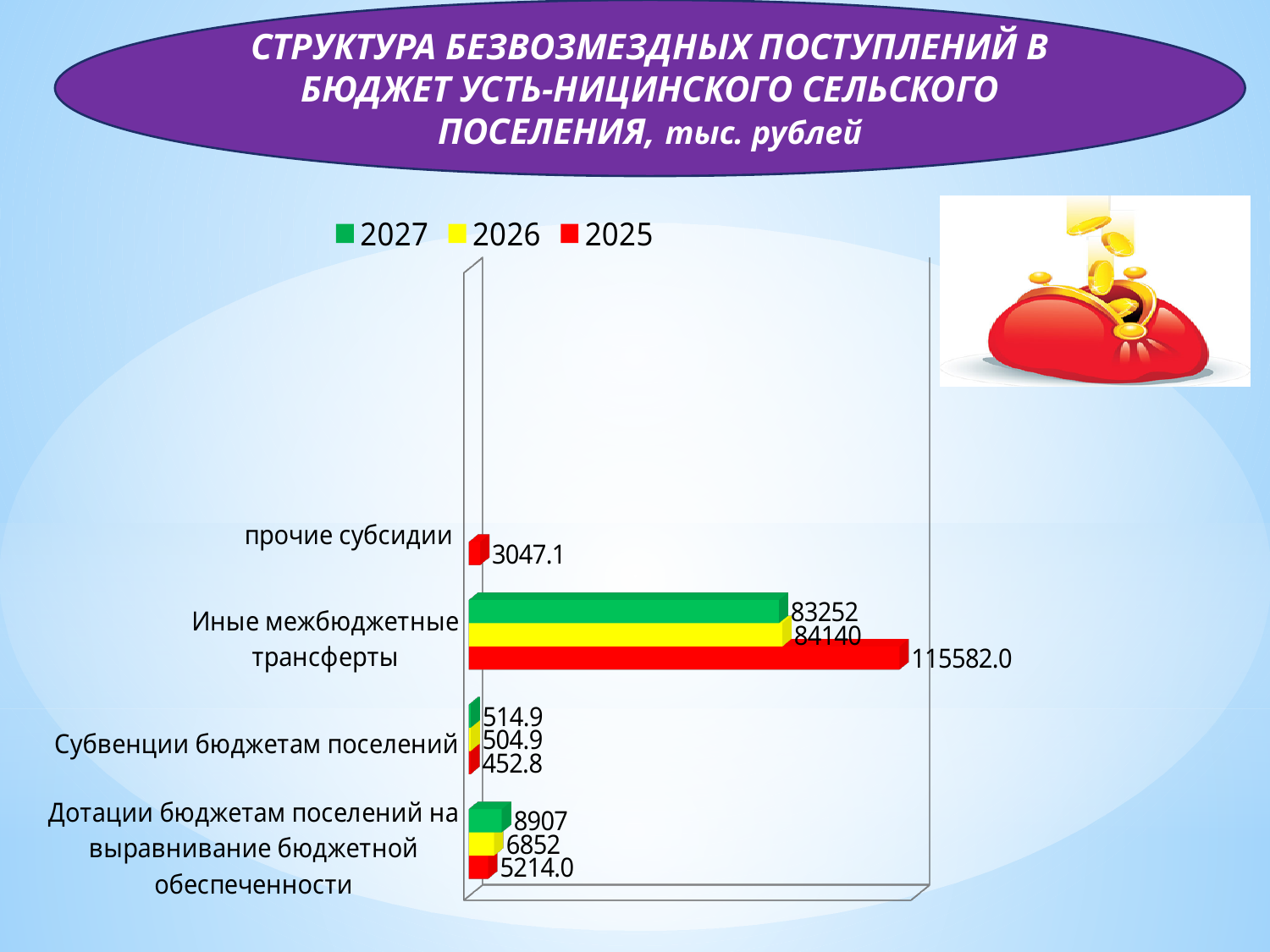
What is the value for 2026 for "Субвенции бюджетам поселений"? 504.9 What is the difference between the 2026 and 2027 values for "Иные межбюджетные трансферты"? 888 For "Субвенции бюджетам поселений", which is larger: the 2027 value or the 2025 value? 2027 Which category has the highest value for 2025? Иные межбюджетные трансферты Which category has the lowest value for 2027? Субвенции бюджетам поселений What is the value for 2025 for "прочие субсидии"? 3047.1 What kind of chart is shown on the slide? Bar chart Which colour represents the 2026 series in the legend? Yellow What is the value for 2027 for "Дотации бюджетам поселений на выравнивание бюджетной обеспеченности"? 8907 How many series does the legend list? 3 What is the value for 2025 for "Иные межбюджетные трансферты"? 115582.0 What is the difference between the 2027 and 2026 values for "Дотации бюджетам поселений на выравнивание бюджетной обеспеченности"? 2055